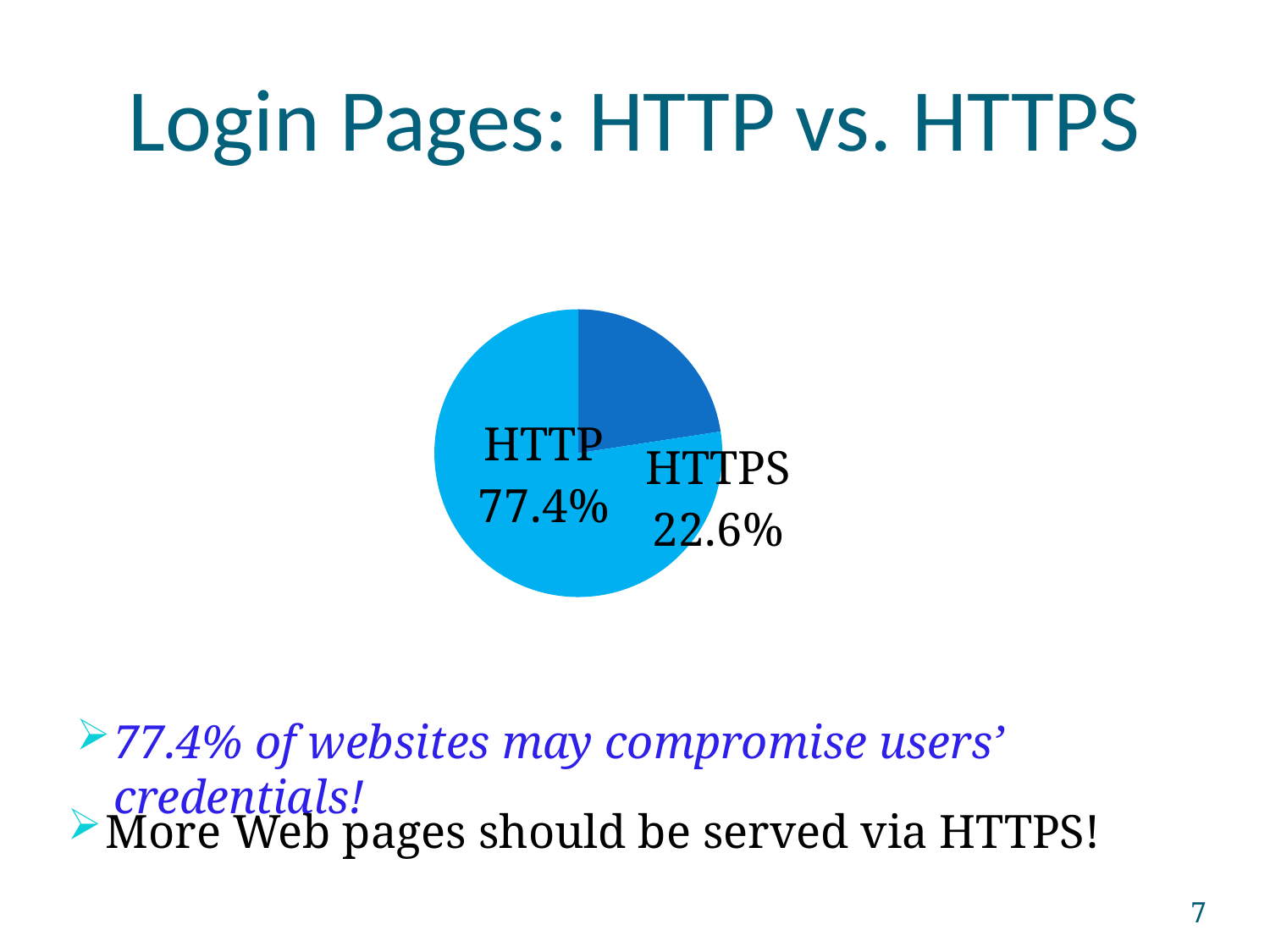
What is the difference in percentage points between the HTTP and HTTPS slices? 54.8 Which is larger, the HTTP slice or the HTTPS slice? HTTP How many slices does the pie chart have? 2 What share of login pages is served via HTTPS? 22.6% Is the HTTPS share greater or less than 25%? less What is the title of the slide containing the pie chart? Login Pages: HTTP vs. HTTPS Which slice of the pie is the smallest? HTTPS Is the HTTP share greater or less than 75%? greater Which slice is drawn in the darker blue colour? HTTPS What share of login pages is served via HTTP? 77.4% What kind of chart is shown on the slide? pie chart Which slice of the pie is the largest? HTTP